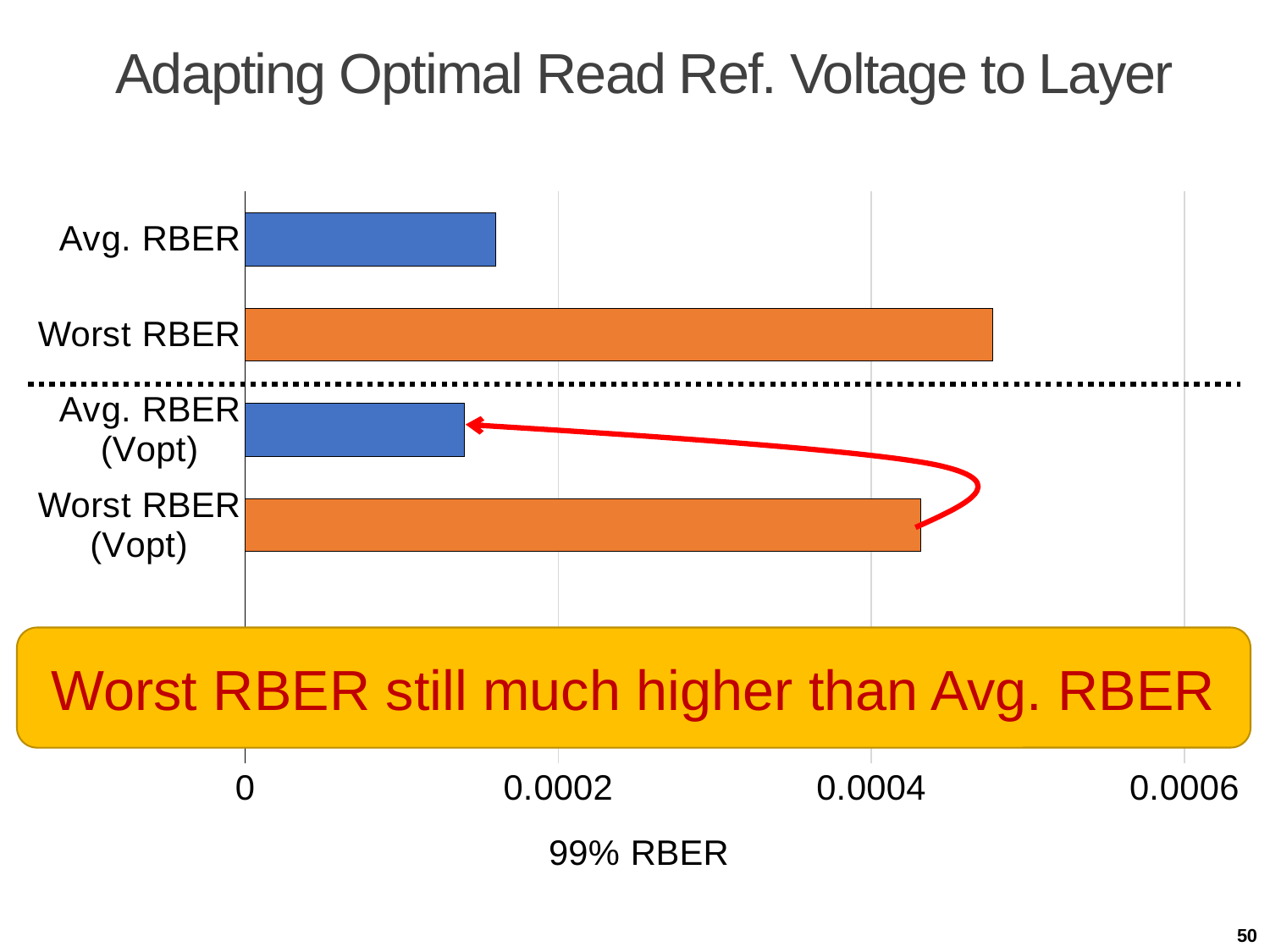
Is the value for Worst RBER (Vopt) greater or less than 0.0004? greater Is the value for Avg. RBER greater or less than 0.0002? less What is the largest value labelled on the x axis? 0.0006 Is the value for Avg. RBER (Vopt) greater or less than 0.0002? less What is the title of the x axis? 99% RBER Which is larger, the value for Worst RBER or the value for Worst RBER (Vopt)? Worst RBER Which is larger, the value for Worst RBER or the value for Avg. RBER? Worst RBER What kind of chart is shown on the slide? bar chart Which category has the highest 99% RBER value? Worst RBER How many categories (bars) does the chart show? 4 Which is larger, the value for Worst RBER (Vopt) or the value for Avg. RBER (Vopt)? Worst RBER (Vopt)